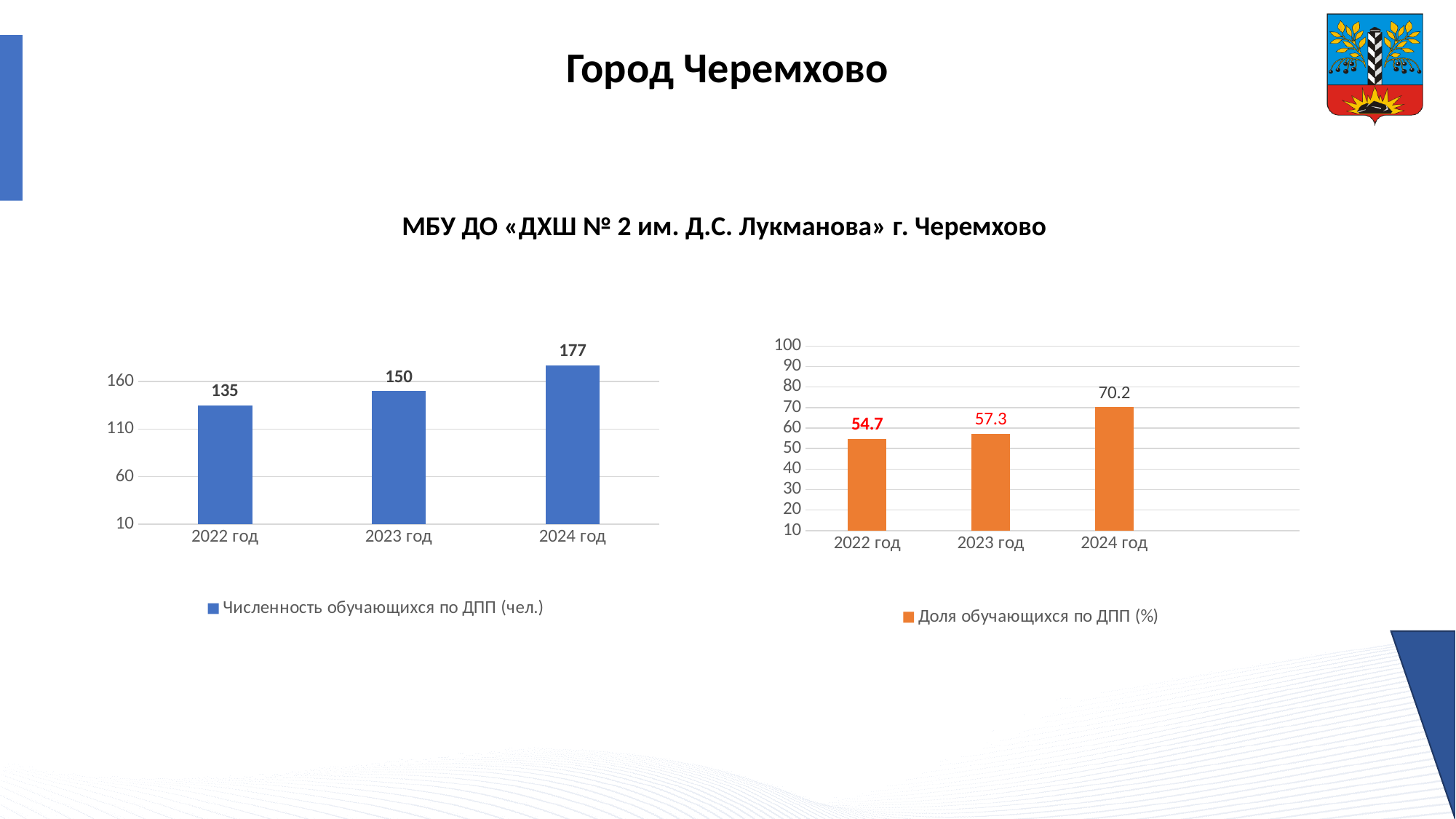
In the right chart (Доля обучающихся по ДПП), what is the difference between the values for 2024 год and 2023 год? 12.9 In the right chart (Доля обучающихся по ДПП), which is larger: the value for 2023 год or 2022 год? 2023 год In the left chart (Численность обучающихся по ДПП), what is the difference between the values for 2024 год and 2022 год? 42 How many bars are in the left chart (Численность обучающихся по ДПП)? 3 What type of chart is the right chart (Доля обучающихся по ДПП)? Bar chart In the right chart (Доля обучающихся по ДПП), what is the value for 2022 год? 54.7 In the right chart (Доля обучающихся по ДПП), which year has the lowest value? 2022 год In the left chart (Численность обучающихся по ДПП), which year has the highest value? 2024 год In the left chart (Численность обучающихся по ДПП), do the values rise or fall from 2022 год to 2024 год? Rise In the right chart (Доля обучающихся по ДПП), what is the value for 2024 год? 70.2 In the left chart (Численность обучающихся по ДПП), what is the value for 2023 год? 150 In the left chart (Численность обучающихся по ДПП), what is the value for 2024 год? 177